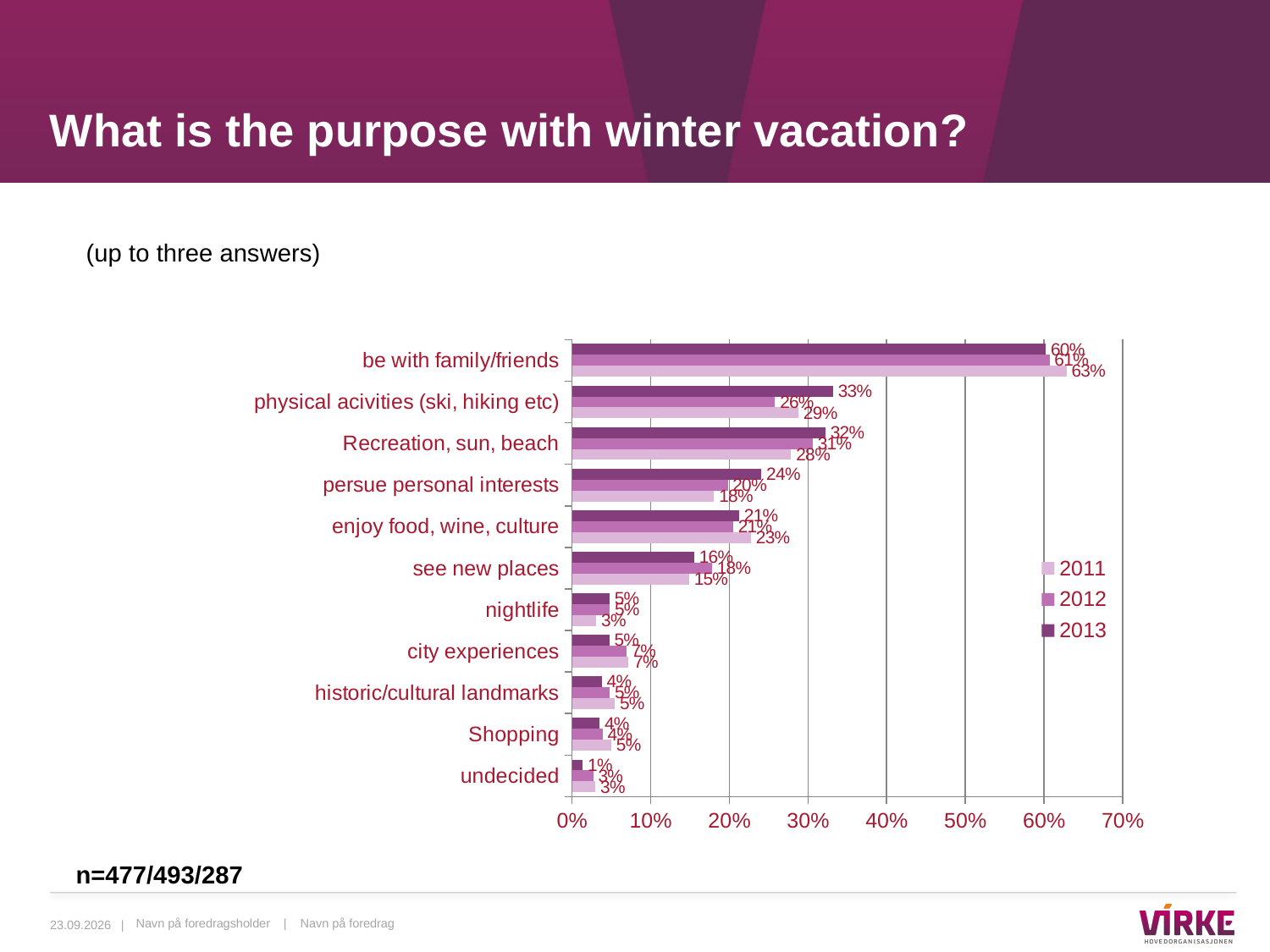
Which category has the lowest value in 2013? undecided Which category has the highest value in 2013? be with family/friends How many categories are shown on the chart? 11 What is the 2011 value for 'enjoy food, wine, culture'? 23% What is the 2013 value for 'physical acivities (ski, hiking etc)'? 33% What is the difference between the 2013 and 2011 values for 'persue personal interests'? 6% Which series is shown in the lightest colour in the legend? 2011 What is the 2011 value for 'be with family/friends'? 63% What type of chart is shown on the slide? bar chart What is the 2013 value for 'persue personal interests'? 24% How many series does the legend list? 3 Which is larger for 'Recreation, sun, beach': the 2013 value or the 2011 value? 2013